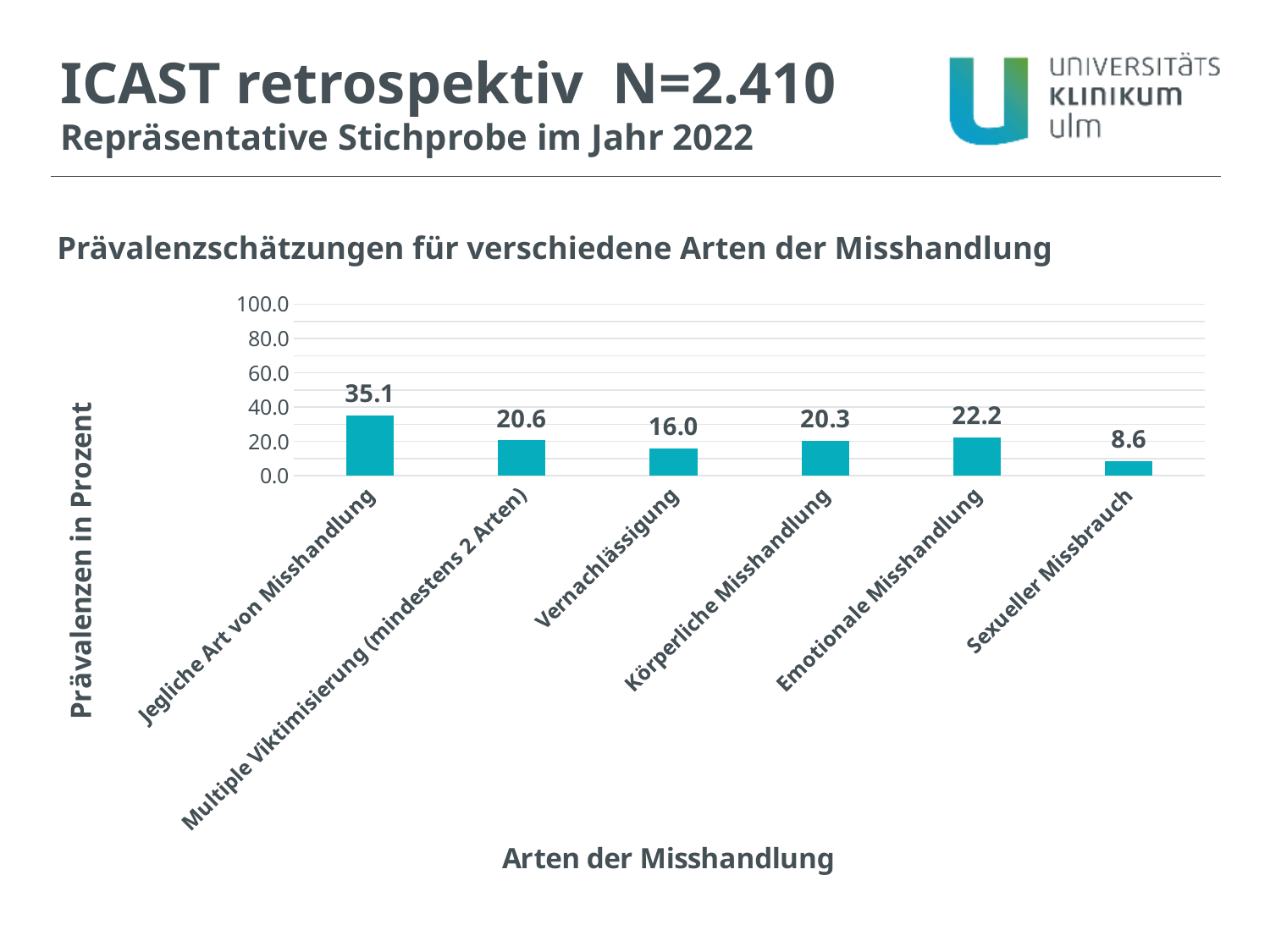
How many categories are shown on the x axis? 6 Which category has the highest value? Jegliche Art von Misshandlung What is the value for Vernachlässigung? 16.0 Which is larger, the value for Emotionale Misshandlung or the value for Vernachlässigung? Emotionale Misshandlung What is the value for Jegliche Art von Misshandlung? 35.1 What is the value for Sexueller Missbrauch? 8.6 What is the label of the y axis? Prävalenzen in Prozent Which category has the lowest value? Sexueller Missbrauch What kind of chart is shown on the slide? bar chart What is the difference between the values for Jegliche Art von Misshandlung and Sexueller Missbrauch? 26.5 Is the value for Jegliche Art von Misshandlung greater or less than 20.0? greater What is the value for Emotionale Misshandlung? 22.2